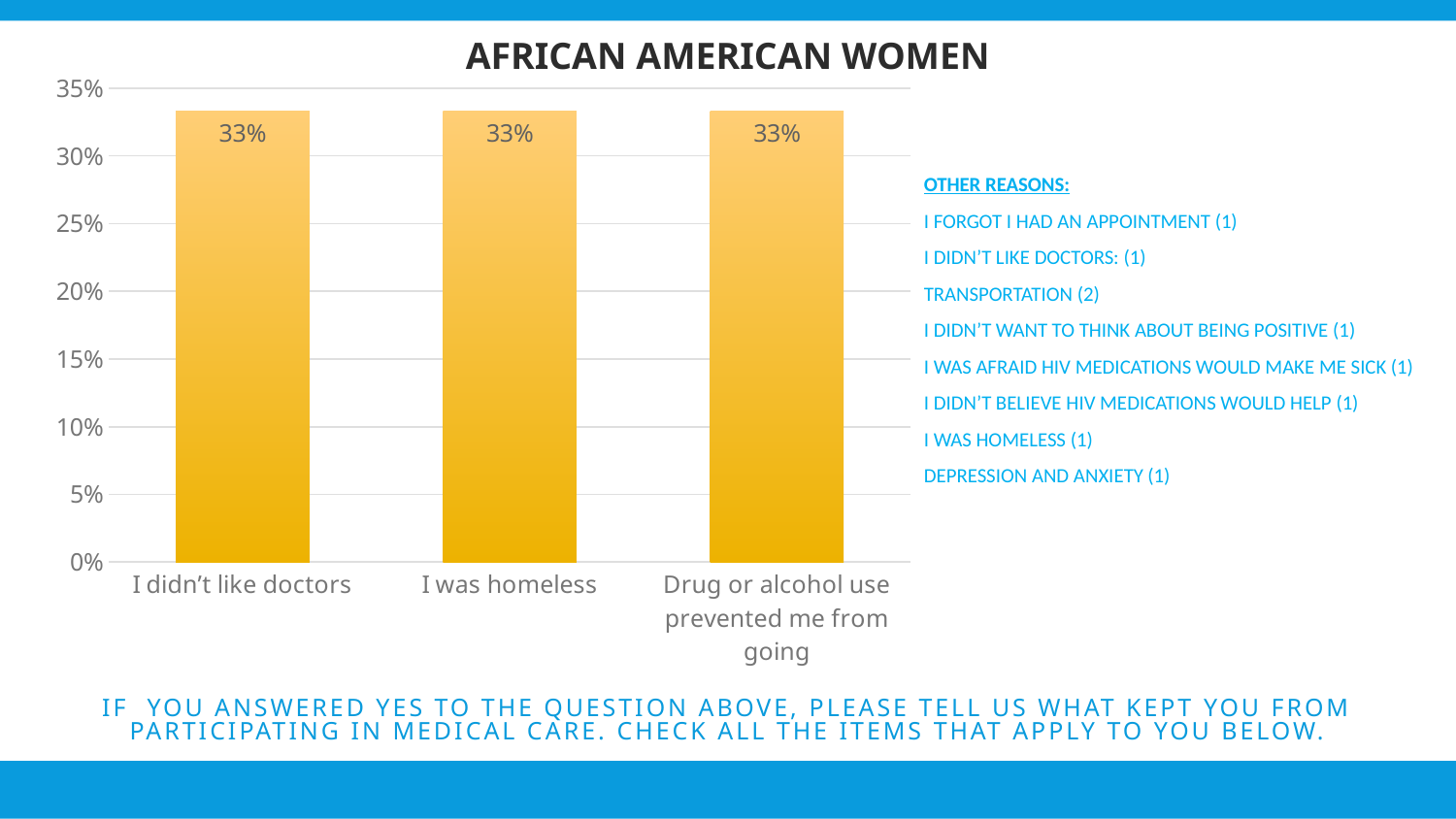
What is the difference between the values for "I was homeless" and "I didn't like doctors"? 0% What is the value for "I didn't like doctors"? 33% How many categories are plotted on the chart? 3 What is the value for "Drug or alcohol use prevented me from going"? 33% What is the value for "I was homeless"? 33% Is the value for "I was homeless" greater or less than 30%? greater Which is larger, the value for "I didn't like doctors" or the value for "Drug or alcohol use prevented me from going"? They are equal Do the values rise, fall, or stay flat across the categories from left to right? Stay flat What kind of chart is shown on the slide? Bar chart What is the highest value shown on the y axis of the chart? 35% Is the value for "Drug or alcohol use prevented me from going" greater or less than 35%? less What is the title of the chart? AFRICAN AMERICAN WOMEN